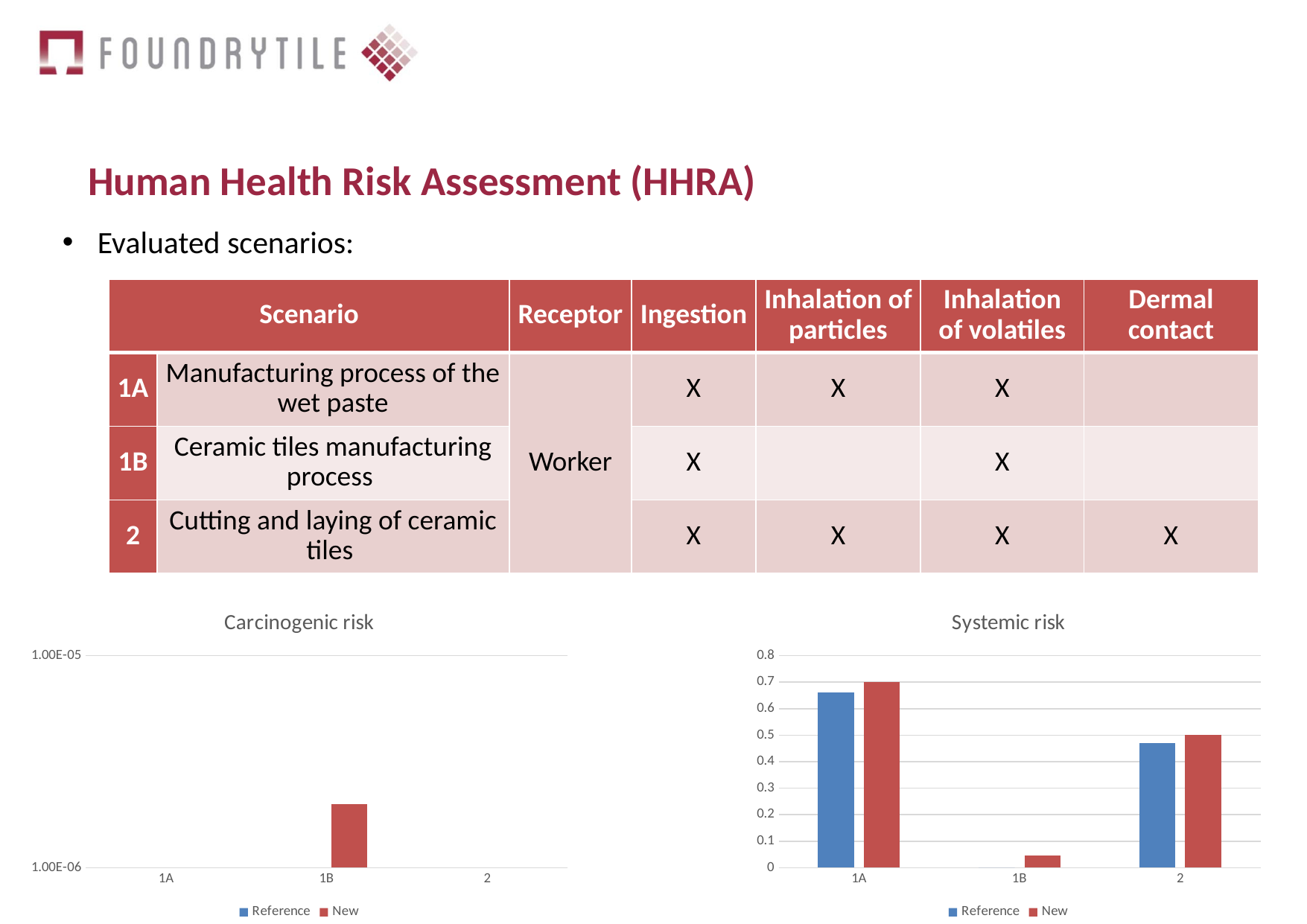
In the Systemic risk chart, which category has the lowest New value? 1B What kind of chart is the Carcinogenic risk chart? bar chart In the Systemic risk chart, is the New value for 1B greater or less than 0.1? less In the Carcinogenic risk chart, which category is the only one with a visible bar? 1B What are the two legend entries of the Carcinogenic risk chart? Reference and New In the Systemic risk chart, is the Reference value for 1A greater or less than 0.6? greater How many categories are shown on the x axis of the Carcinogenic risk chart? 3 How many series does the legend of the Systemic risk chart list? 2 In the Systemic risk chart, which is larger: the Reference value for 1A or the Reference value for 2? 1A In the Systemic risk chart, which category has the highest New value? 1A What kind of chart is the Systemic risk chart? bar chart In the Systemic risk chart, is the Reference value for 2 greater or less than 0.5? less